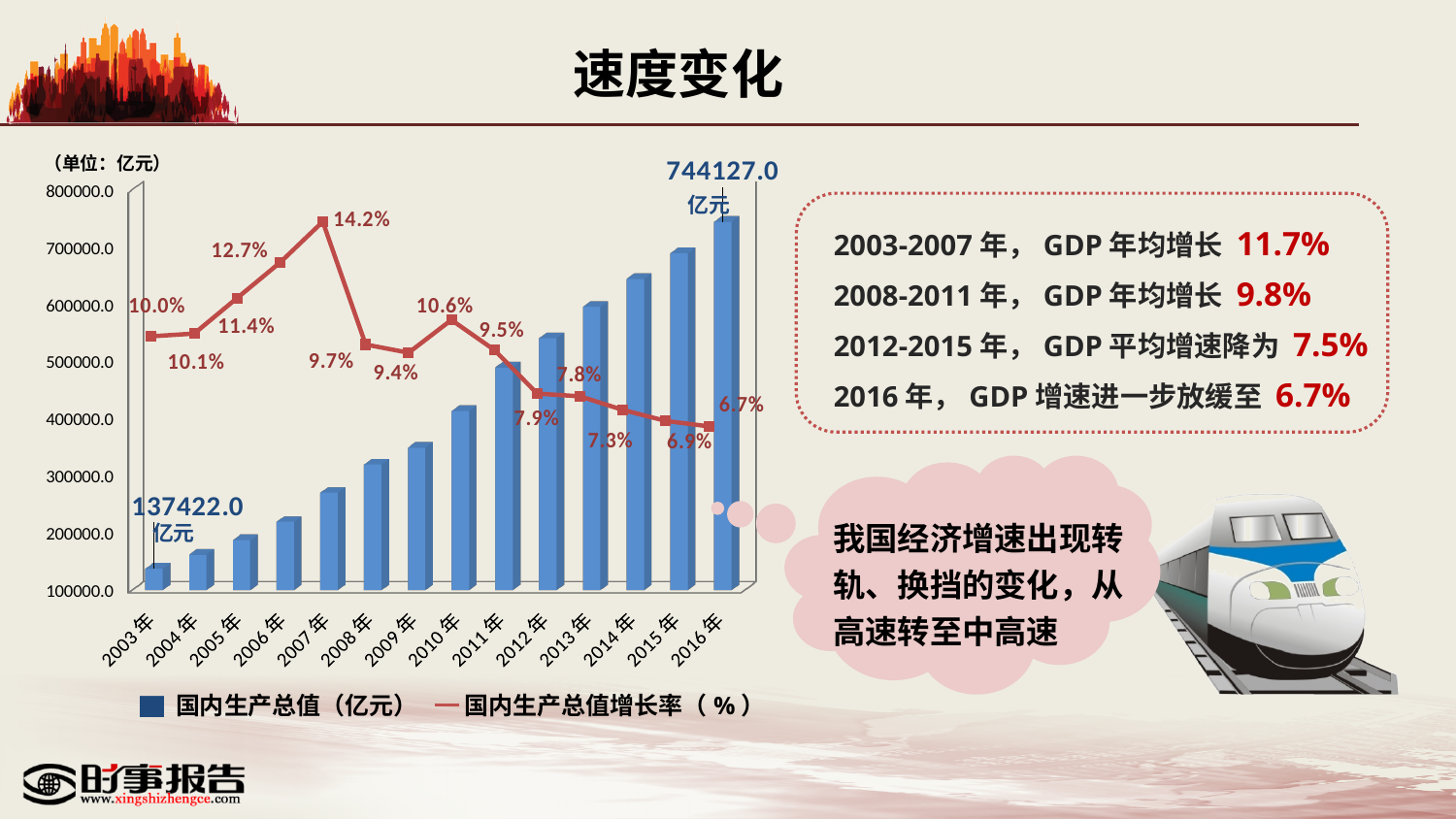
Which is larger, the growth rate for 2005 年 or the growth rate for 2009 年? 2005 年 How many years are shown on the x axis? 14 What is the GDP value labelled for 2003 年? 137422.0 亿元 Do the GDP bars rise or fall from 2003 年 to 2016 年? rise Which year has the lowest GDP growth rate on the line? 2016 年 What is the GDP growth rate shown for 2010 年? 10.6% Is the GDP bar for 2013 年 greater or less than 500000.0? greater What is the difference between the growth rate in 2007 年 and the growth rate in 2016 年? 7.5% Which year has the highest GDP growth rate on the line? 2007 年 What is the GDP value labelled for 2016 年? 744127.0 亿元 What is the GDP growth rate shown for 2007 年? 14.2% How many series does the legend list? 2